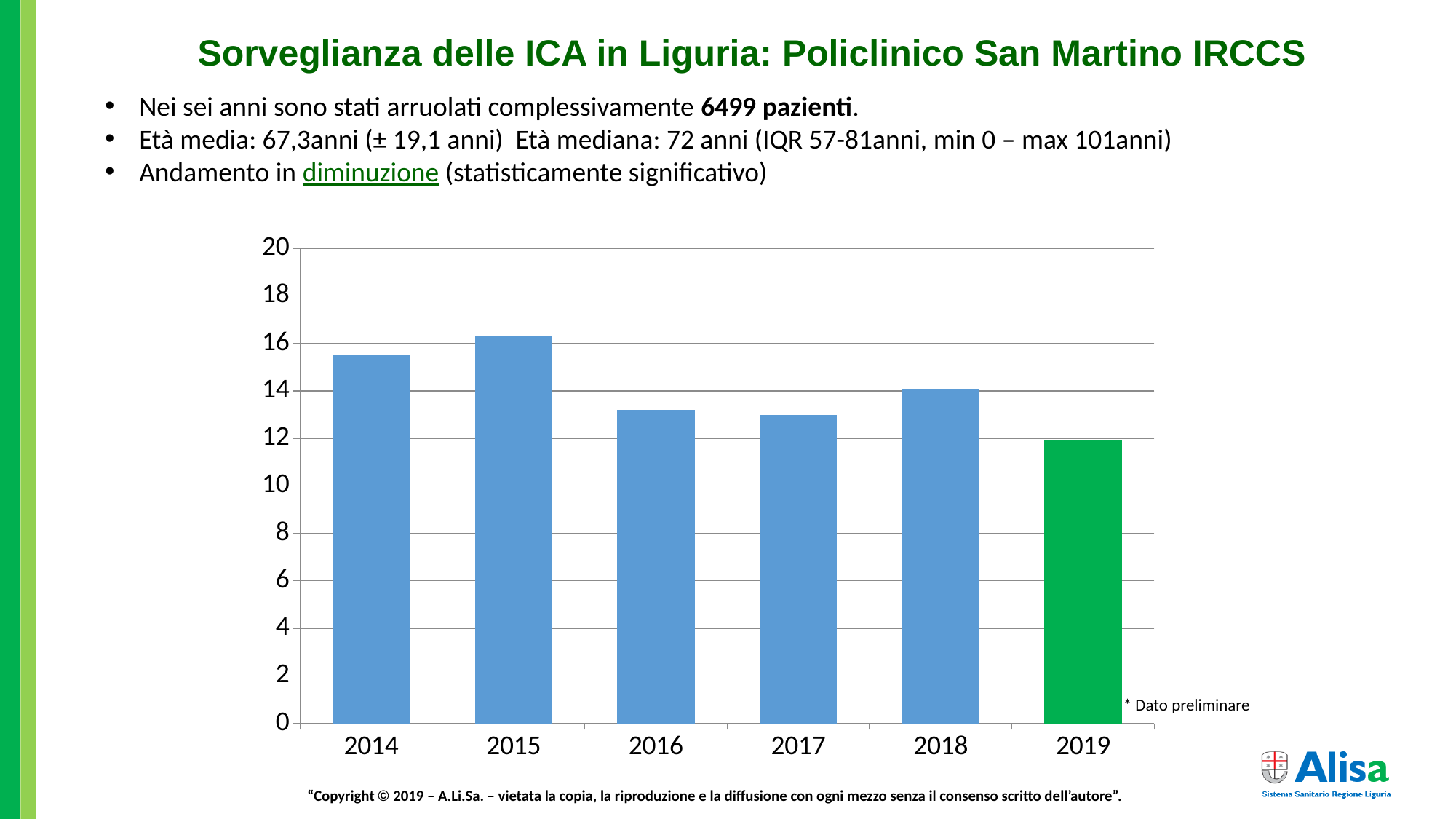
Which year's bar is coloured green instead of blue? 2019 Is the value for 2016 greater or less than 14? less Which is larger, the value for 2018 or the value for 2016? 2018 Is the value for 2014 greater or less than 14? greater Do the values generally rise or fall from 2014 to 2019? fall Which is larger, the value for 2014 or the value for 2018? 2014 Is the value for 2019 greater or less than 14? less How many years are shown on the x axis of the chart? 6 What kind of chart is shown on the slide? bar chart Which year has the lowest bar in the chart? 2019 Which year has the highest bar in the chart? 2015